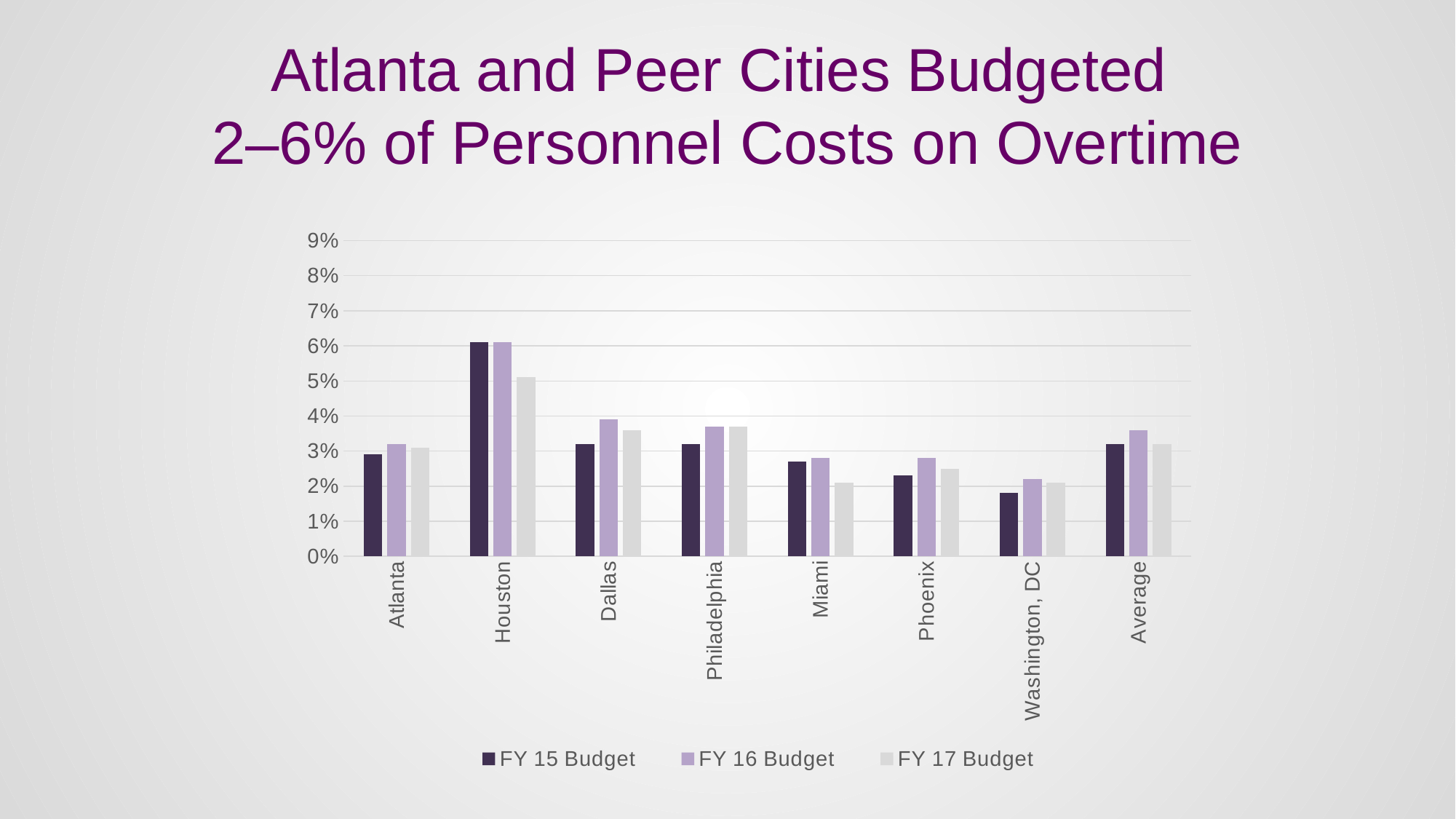
Is the FY 15 Budget value for Washington, DC greater or less than 2%? less Which is larger, the FY 15 Budget value for Miami or for Phoenix? Miami Is the FY 16 Budget value for Dallas greater or less than 3%? greater What are the three series listed in the chart's legend? FY 15 Budget, FY 16 Budget, FY 17 Budget Is the FY 17 Budget value for Miami greater or less than 3%? less Which is larger, the FY 17 Budget value for Houston or for Dallas? Houston Which category has the lowest FY 15 Budget value? Washington, DC How many series does the chart's legend list? 3 How many categories are shown along the x axis of the chart? 8 What kind of chart is shown on the slide? bar chart Which city has the highest FY 15 Budget value? Houston